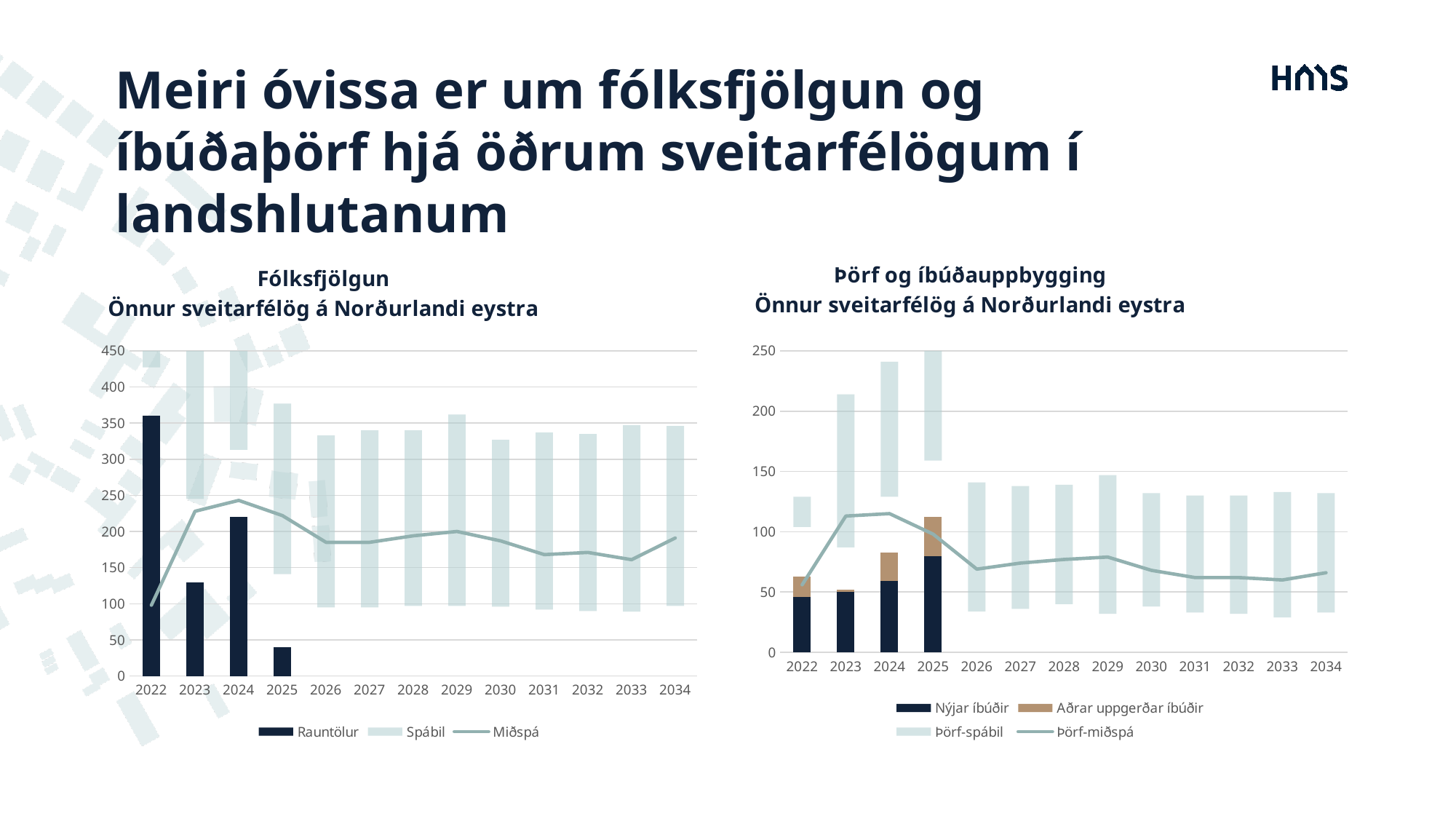
In the Fólksfjölgun chart, which year has the lowest Rauntölur bar? 2025 How many series does the legend of the Fólksfjölgun chart list? 3 What is the name of the line series in the Þörf og íbúðauppbygging chart's legend? Þörf-miðspá In the Fólksfjölgun chart, is the Rauntölur value for 2025 greater or less than 50? less In the Fólksfjölgun chart, which year has the highest Rauntölur bar? 2022 How many years are shown on the x axis of the Fólksfjölgun chart? 13 In the Þörf og íbúðauppbygging chart, is the Nýjar íbúðir value for 2025 greater or less than 50? greater In the Fólksfjölgun chart, is the Rauntölur value for 2024 larger than the Rauntölur value for 2023? Yes In the Fólksfjölgun chart, is the Rauntölur value for 2022 greater or less than 350? greater In the Þörf og íbúðauppbygging chart, which year has the tallest stacked bar of Nýjar íbúðir and Aðrar uppgerðar íbúðir? 2025 How many series does the legend of the Þörf og íbúðauppbygging chart list? 4 In the Þörf og íbúðauppbygging chart, does the Þörf-miðspá line rise or fall from 2025 to 2026? Fall